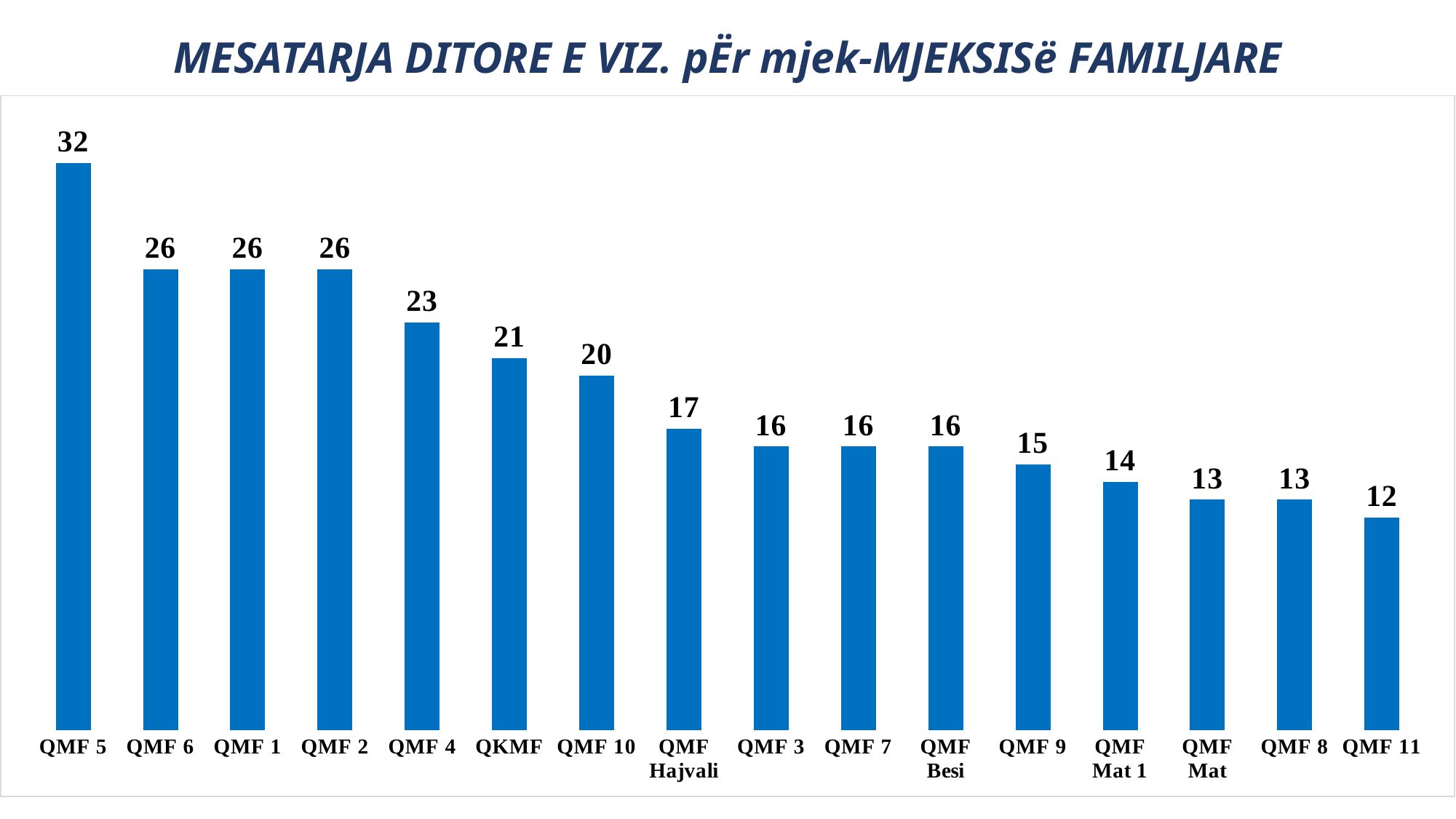
Which is larger, the value for QMF 9 or the value for QMF 8? QMF 9 What is the difference between the values for QMF 4 and QMF 10? 3 What is the value for QMF Mat 1? 14 What is the difference between the values for QMF 5 and QMF 11? 20 Which category has the lowest value? QMF 11 What is the value for QMF Hajvali? 17 How many categories are shown in the chart? 16 What kind of chart is shown on the slide? Bar chart What is the value for QKMF? 21 Do the values rise or fall from left to right along the x axis? Fall Which category has the highest value? QMF 5 What is the value for QMF 5? 32